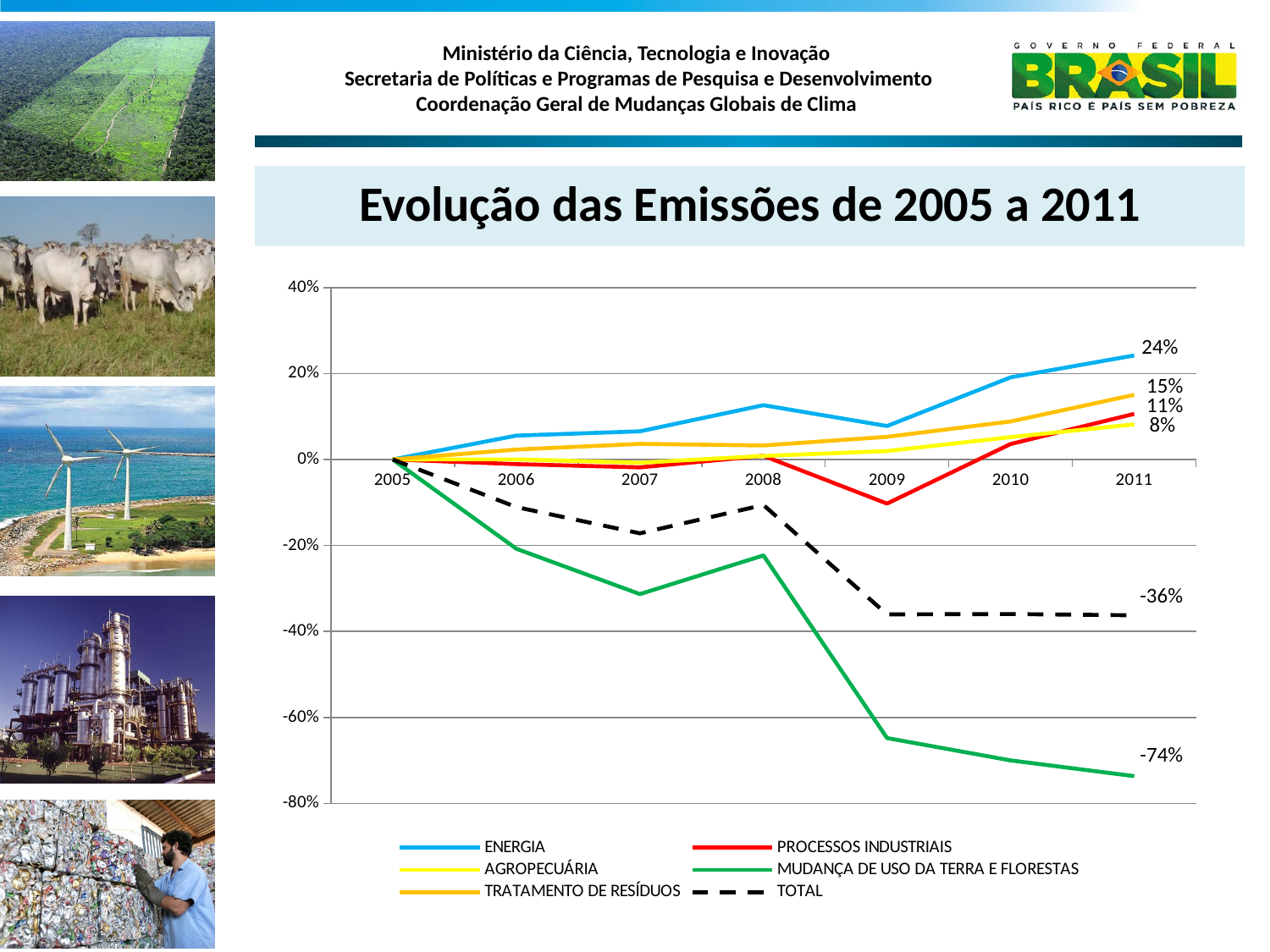
What is the value for ENERGIA in 2011? 24% How many series does the legend list? 6 How many years are shown on the x axis? 7 What type of chart is shown on the slide? line chart What is the value for MUDANÇA DE USO DA TERRA E FLORESTAS in 2011? -74% What is the value for TOTAL in 2011? -36% What is the difference between the 2011 values for ENERGIA and AGROPECUÁRIA? 16 percentage points Which series has the highest value in 2011? ENERGIA What is the value for AGROPECUÁRIA in 2011? 8% Is the value for MUDANÇA DE USO DA TERRA E FLORESTAS in 2009 greater or less than -60%? less Which series has the lowest value in 2011? MUDANÇA DE USO DA TERRA E FLORESTAS What is the title of the chart? Evolução das Emissões de 2005 a 2011